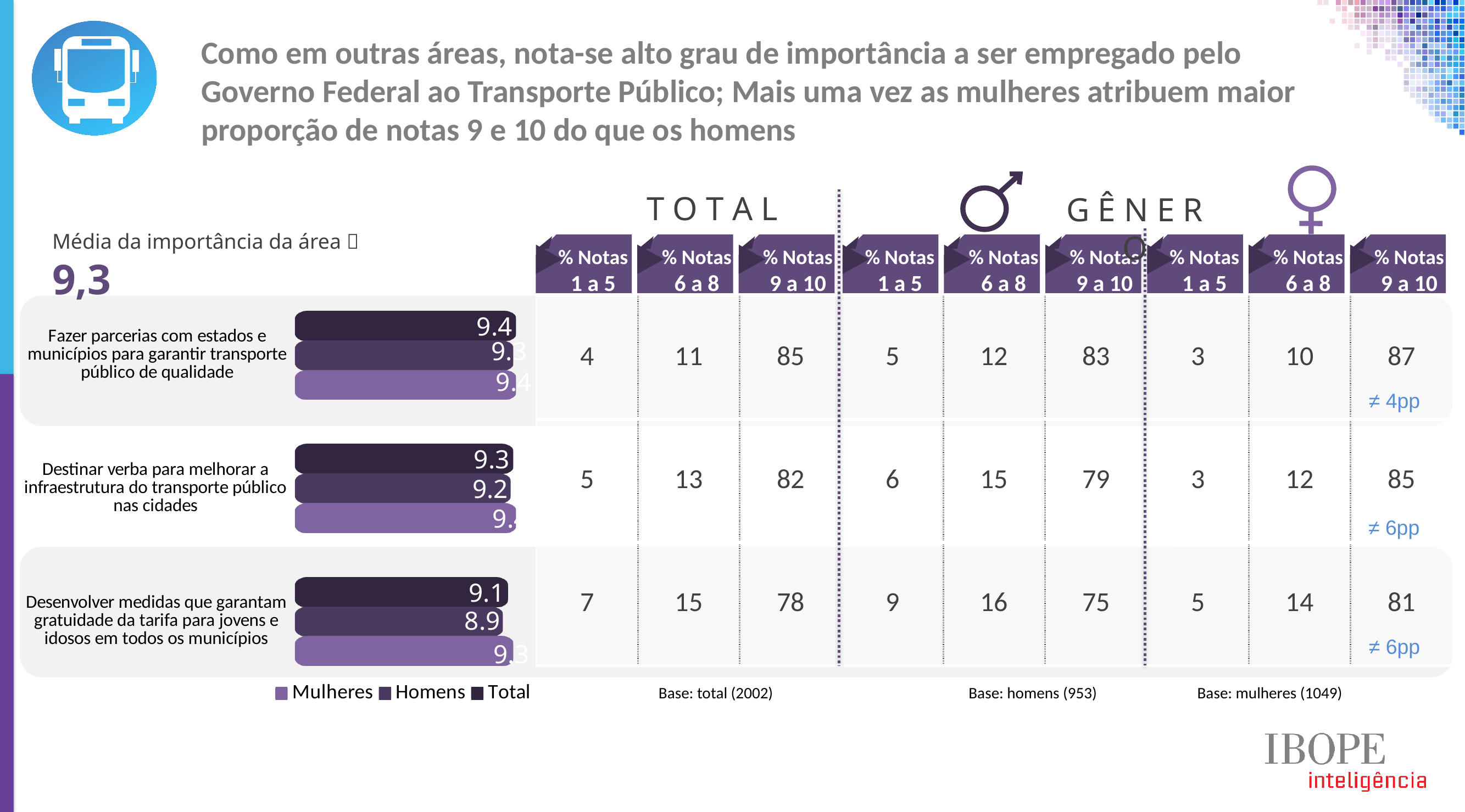
In the bar chart, what is the Total value for 'Fazer parcerias com estados e municípios para garantir transporte público de qualidade'? 9.4 In the bar chart, which category has the lowest Homens value? Desenvolver medidas que garantam gratuidade da tarifa para jovens e idosos em todos os municípios In the bar chart, what is the Homens value for 'Destinar verba para melhorar a infraestrutura do transporte público nas cidades'? 9.2 What kind of chart is used to show the average importance scores on the slide? bar chart How many categories (measures) are shown in the bar chart? 3 How many series does the legend of the bar chart list? 3 In the bar chart, what is the Total value for 'Destinar verba para melhorar a infraestrutura do transporte público nas cidades'? 9.3 In the bar chart, what is the Homens value for 'Desenvolver medidas que garantam gratuidade da tarifa para jovens e idosos em todos os municípios'? 8.9 In the bar chart, which has the higher Total value: 'Fazer parcerias com estados e municípios...' or 'Desenvolver medidas que garantam gratuidade da tarifa...'? Fazer parcerias com estados e municípios para garantir transporte público de qualidade What are the three legend entries of the bar chart? Mulheres, Homens, Total In the bar chart, what is the difference between the Total value for 'Fazer parcerias com estados e municípios...' (9.4) and the Total value for 'Desenvolver medidas que garantam gratuidade da tarifa...' (9.1)? 0.3 What is the 'Média da importância da área' value shown next to the bar chart? 9,3